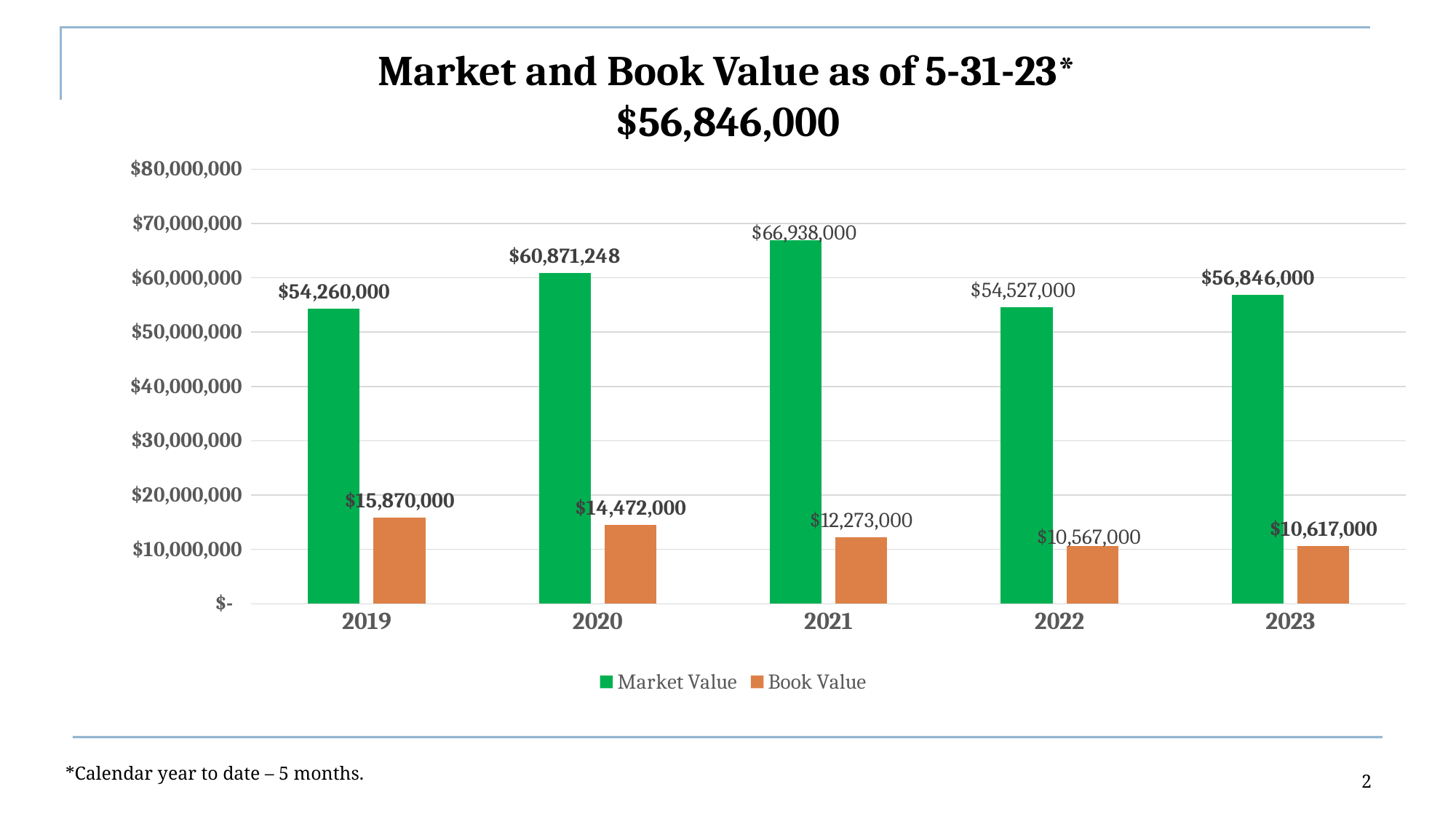
How many series does the legend list? 2 Is the Market Value for 2022 greater or less than $60,000,000? less Which year has the highest Book Value? 2019 Is the Market Value for 2020 larger or smaller than the Market Value for 2023? larger What is the difference between the Market Value and the Book Value in 2021? $54,665,000 What is the Book Value for 2020? $14,472,000 Which year has the highest Market Value? 2021 What is the Market Value for 2021? $66,938,000 Which year has the lowest Book Value? 2022 How many years are shown on the x axis? 5 What kind of chart is shown on the slide? bar chart By how much did the Book Value decrease from 2019 to 2023? $5,253,000